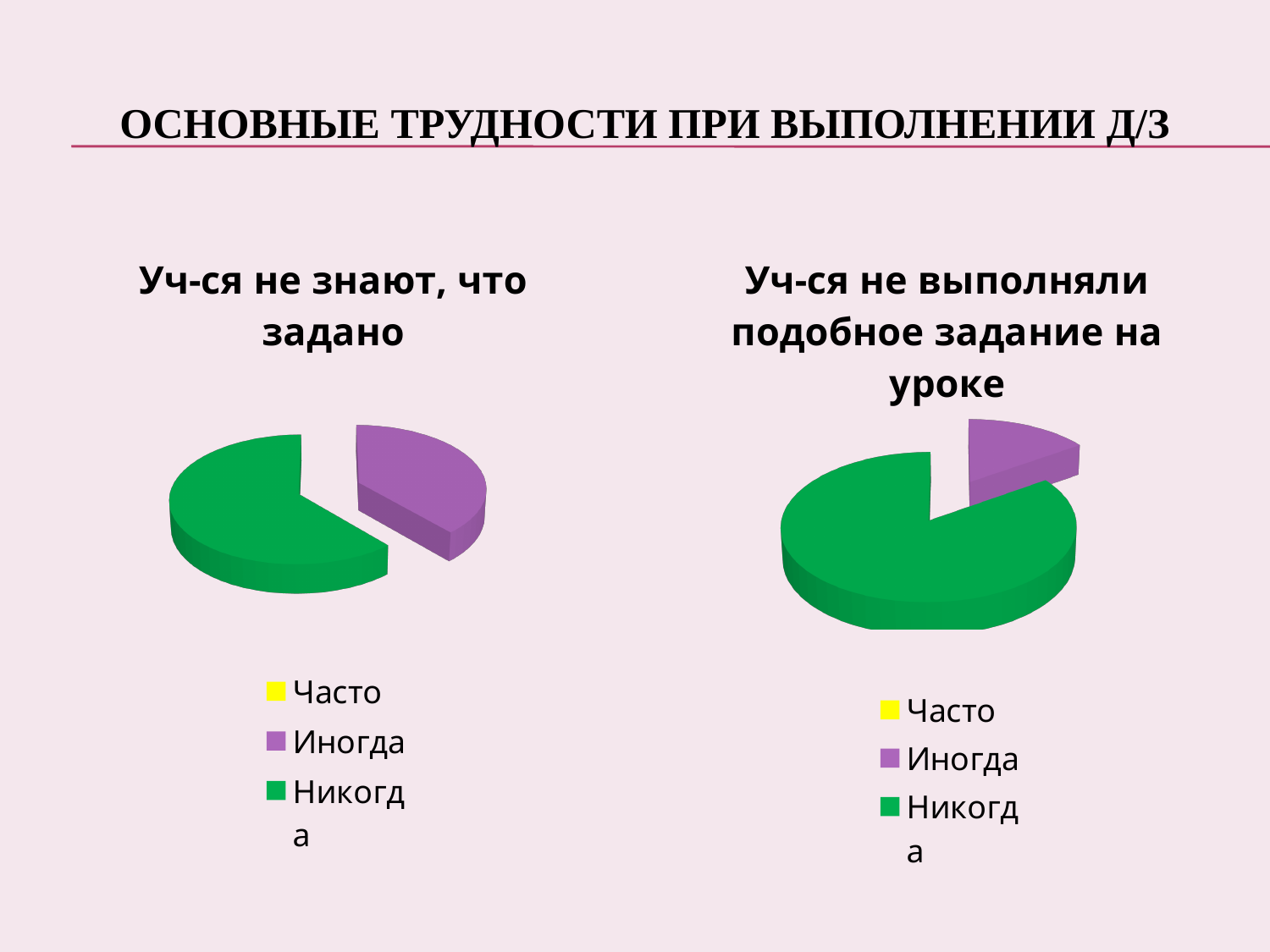
What kind of chart is the left chart titled "Уч-ся не знают, что задано"? pie chart In the right chart "Уч-ся не выполняли подобное задание на уроке", which slice is larger: Иногда or Никогда? Никогда What kind of chart is the right chart titled "Уч-ся не выполняли подобное задание на уроке"? pie chart In the right chart "Уч-ся не выполняли подобное задание на уроке", how many entries does the legend list? 3 In the left chart "Уч-ся не знают, что задано", what colour represents the category Иногда? purple In the left chart "Уч-ся не знают, что задано", how many entries does the legend list? 3 In the left chart "Уч-ся не знают, что задано", which slice is larger: Иногда or Никогда? Никогда What is the title of the slide? ОСНОВНЫЕ ТРУДНОСТИ ПРИ ВЫПОЛНЕНИИ Д/З In the right chart "Уч-ся не выполняли подобное задание на уроке", which category has the largest slice? Никогда In the right chart "Уч-ся не выполняли подобное задание на уроке", which category has the smallest visible slice? Иногда In the left chart "Уч-ся не знают, что задано", which category has the largest slice? Никогда